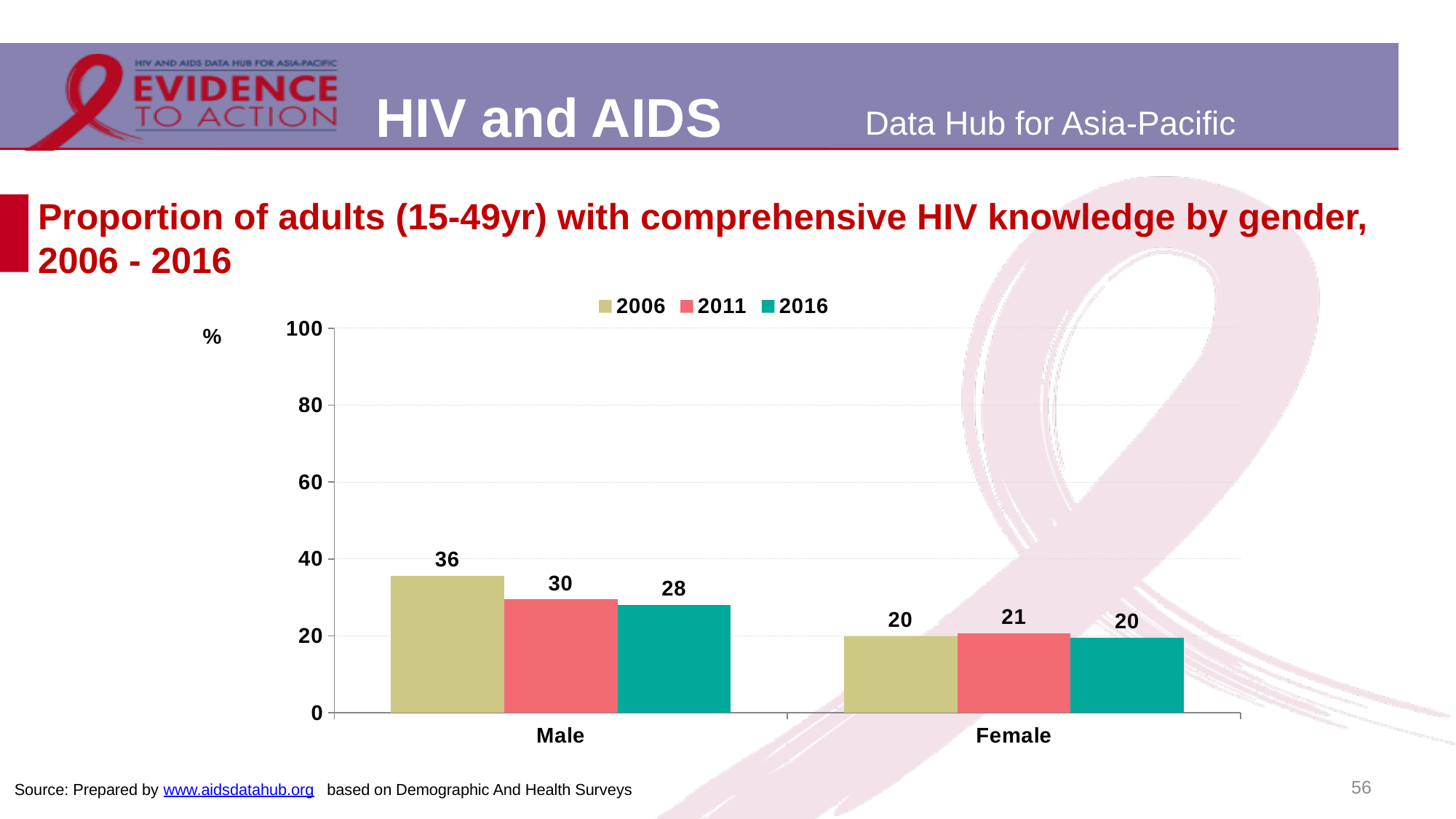
What is the value for Male in 2016? 28 What is the value for Male in 2006? 36 Is the Male value in 2011 larger than the Female value in 2011? Yes What is the difference between the Male values in 2006 and 2011? 6 What is the value for Female in 2011? 21 Do the Male values rise or fall from 2006 to 2016? Fall What is the difference between the Male and Female values in 2016? 8 How many series does the legend list? 3 What kind of chart is shown on the slide? Bar chart Which gender has the higher value in 2006? Male How many categories are shown on the x axis? 2 Is the value for Male in 2006 greater or less than 40? less